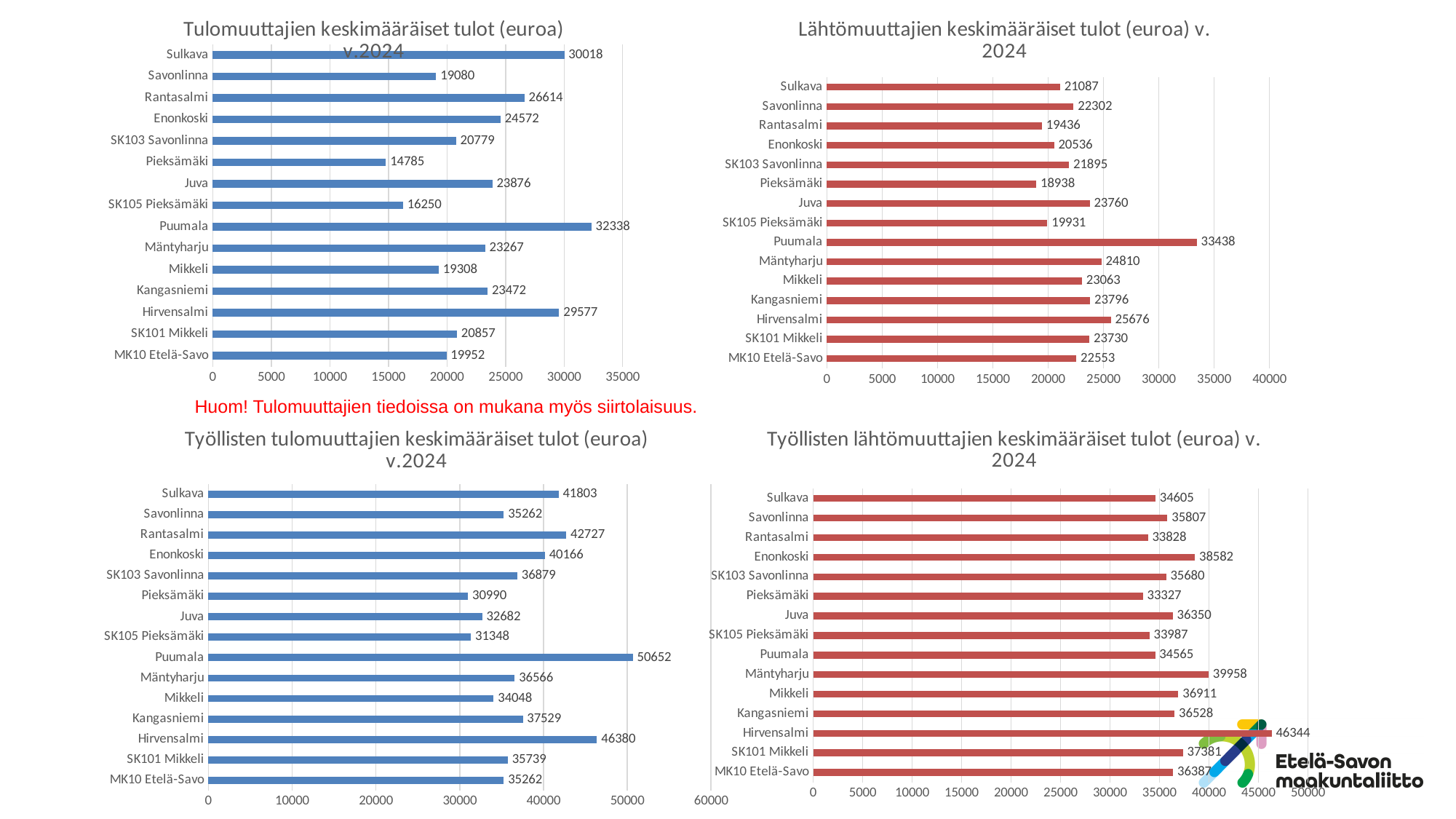
In the chart 'Lähtömuuttajien keskimääräiset tulot (euroa) v. 2024' (top right), what is the value for Hirvensalmi? 25676 In the chart 'Tulomuuttajien keskimääräiset tulot (euroa) v.2024' (top left), which category has the lowest value? Pieksämäki How many categories are shown in the chart 'Lähtömuuttajien keskimääräiset tulot (euroa) v. 2024' (top right)? 15 What type of chart is 'Työllisten tulomuuttajien keskimääräiset tulot (euroa) v.2024' (bottom left)? Bar chart In the chart 'Työllisten lähtömuuttajien keskimääräiset tulot (euroa) v. 2024' (bottom right), what is the value for Mäntyharju? 39958 In the chart 'Työllisten lähtömuuttajien keskimääräiset tulot (euroa) v. 2024' (bottom right), which category has the highest value? Hirvensalmi In the chart 'Tulomuuttajien keskimääräiset tulot (euroa) v.2024' (top left), which is larger, Sulkava or Hirvensalmi? Sulkava In the chart 'Lähtömuuttajien keskimääräiset tulot (euroa) v. 2024' (top right), which category has the highest value? Puumala In the chart 'Työllisten tulomuuttajien keskimääräiset tulot (euroa) v.2024' (bottom left), what is the difference between Puumala and Hirvensalmi? 4272 In the chart 'Työllisten tulomuuttajien keskimääräiset tulot (euroa) v.2024' (bottom left), what is the value for Rantasalmi? 42727 In the chart 'Lähtömuuttajien keskimääräiset tulot (euroa) v. 2024' (top right), what is the difference between Puumala and MK10 Etelä-Savo? 10885 In the chart 'Tulomuuttajien keskimääräiset tulot (euroa) v.2024' (top left), what is the value for Puumala? 32338